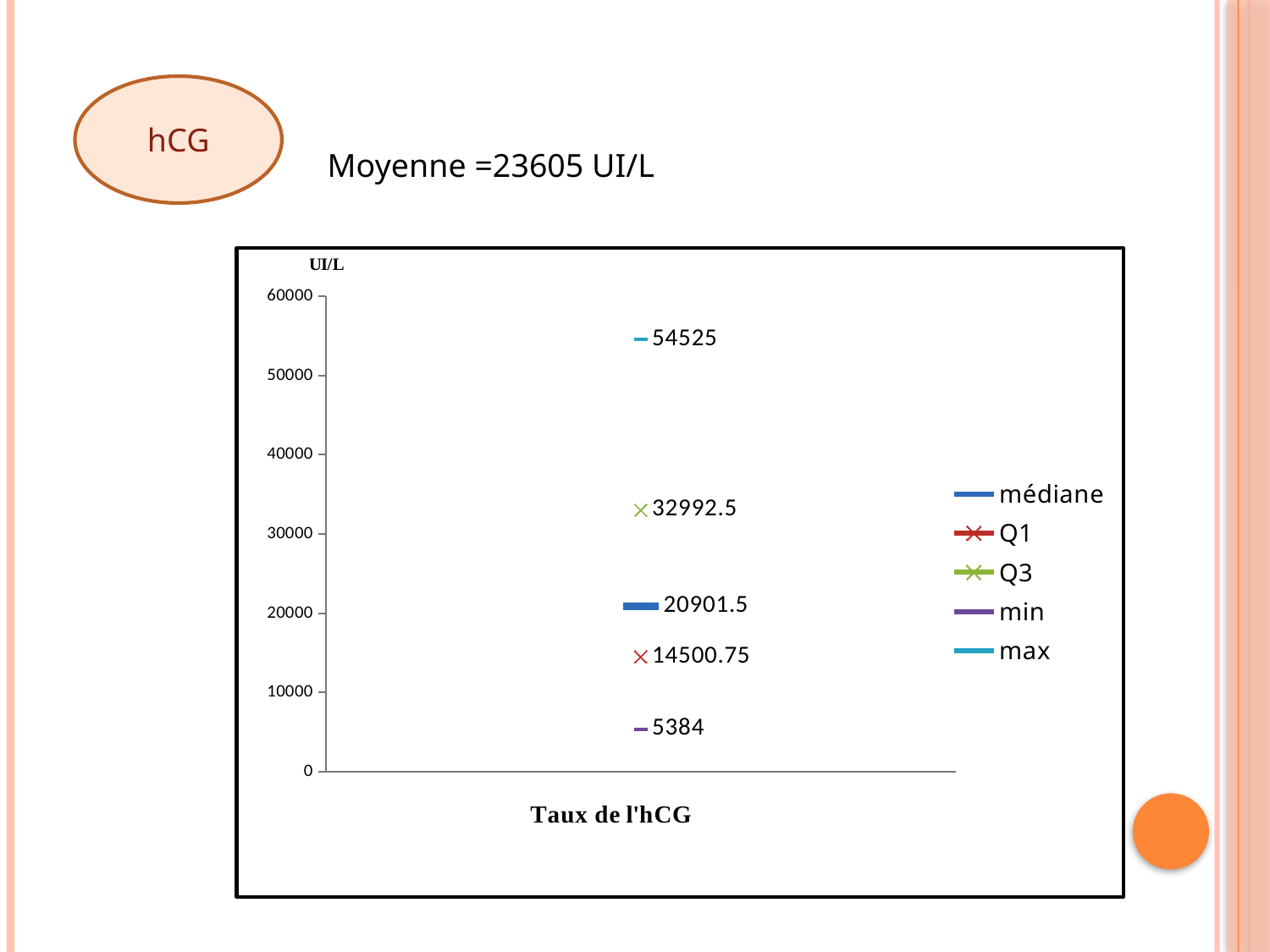
What is the value plotted for the Q3 series? 32992.5 Which is larger, the médiane value or the Q1 value? médiane What is the value plotted for the max series? 54525 How many series does the legend list? 5 Which series has the lowest plotted value? min What is the title shown on the x axis of the chart? Taux de l'hCG What is the value plotted for the min series? 5384 What is the value plotted for the Q1 series? 14500.75 Which series has the highest plotted value? max What is the value plotted for the médiane series? 20901.5 What is the difference between the Q3 value and the Q1 value? 18491.75 What is the difference between the max value and the min value? 49141